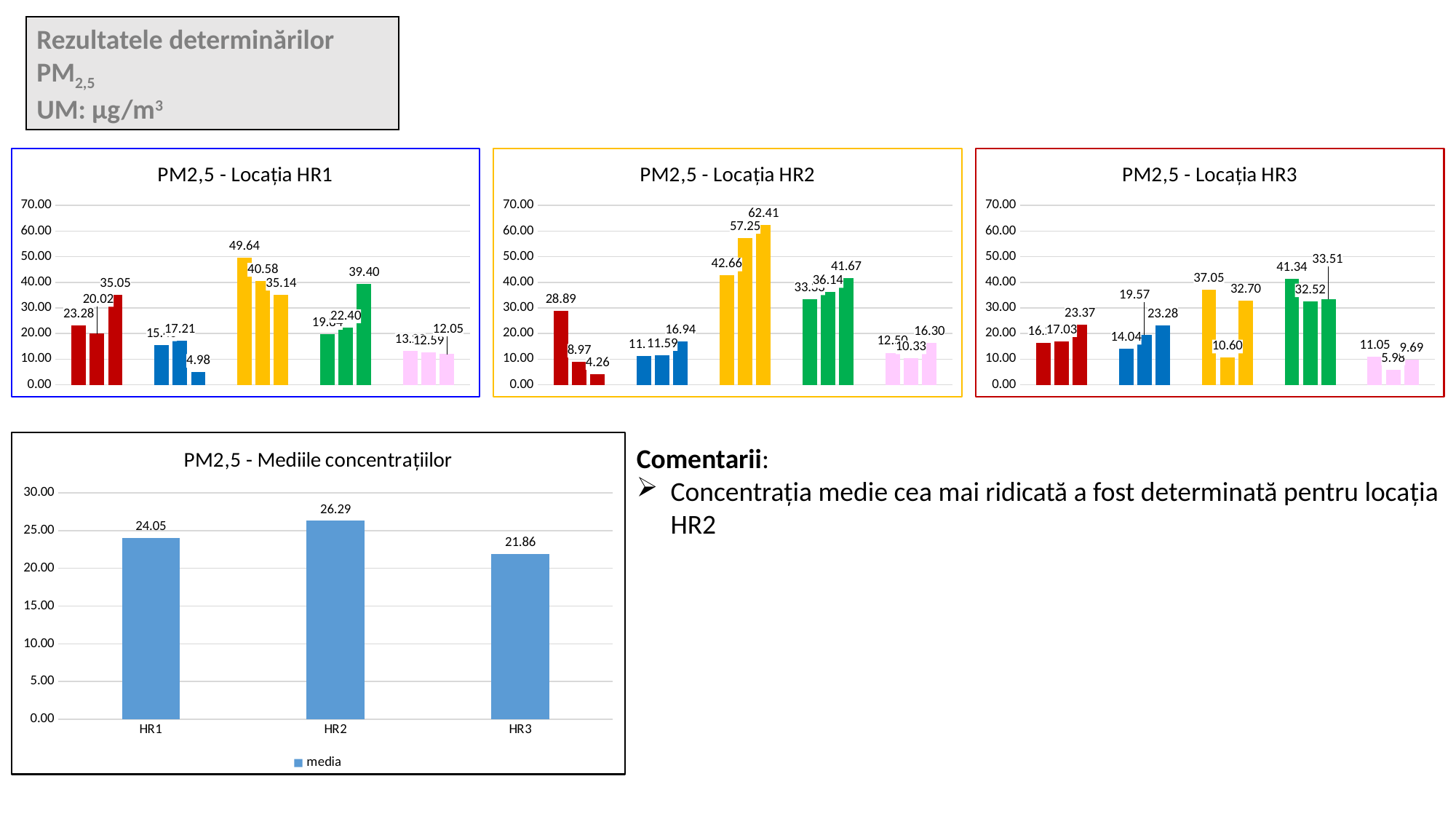
In the PM2,5 - Mediile concentrațiilor chart, which is larger, the value for HR1 or the value for HR3? HR1 In the PM2,5 - Mediile concentrațiilor chart, how many series does the legend list? 1 What kind of chart is the PM2,5 - Mediile concentrațiilor chart? bar chart In the PM2,5 - Mediile concentrațiilor chart, which location has the highest value? HR2 In the PM2,5 - Mediile concentrațiilor chart, how many locations are shown on the x axis? 3 In the PM2,5 - Mediile concentrațiilor chart, what is the value for HR1? 24.05 In the PM2,5 - Locația HR1 chart, what is the highest value labelled on any bar? 49.64 In the PM2,5 - Locația HR2 chart, what is the highest value labelled on any bar? 62.41 In the PM2,5 - Mediile concentrațiilor chart, what is the value for HR2? 26.29 In the PM2,5 - Mediile concentrațiilor chart, which location has the lowest value? HR3 In the PM2,5 - Mediile concentrațiilor chart, what is the difference between the values for HR2 and HR3? 4.43 In the PM2,5 - Mediile concentrațiilor chart, what is the value for HR3? 21.86